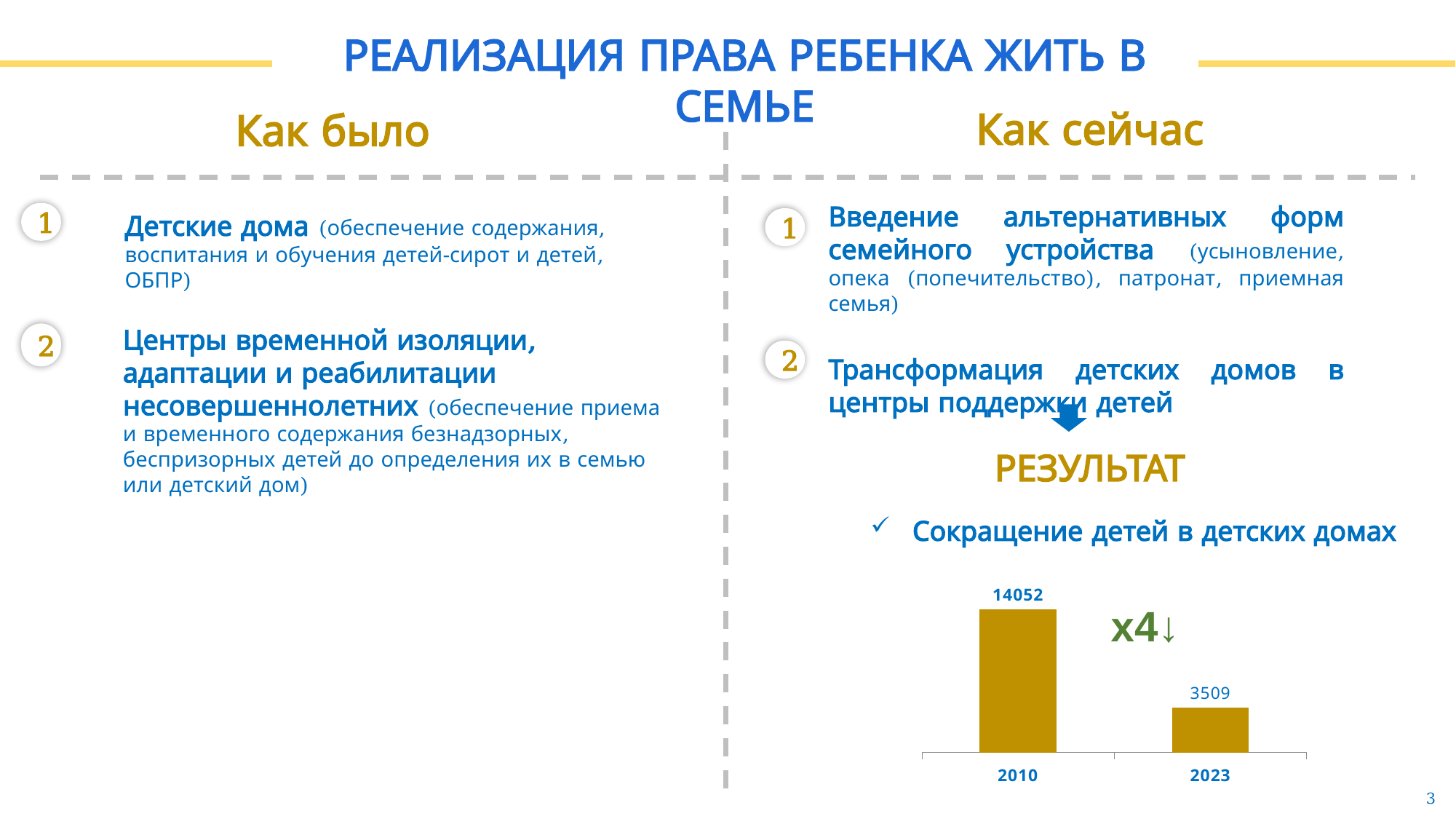
Do the values rise or fall from 2010 to 2023? fall What colour are the bars in the chart? gold What is the value shown for 2010 in the chart? 14052 What kind of chart is shown on the slide? bar chart Which year has the higher value in the chart? 2010 What is the value shown for 2023 in the chart? 3509 Is the value for 2023 larger or smaller than the value for 2010? smaller How many bars are plotted in the chart? 2 What reduction factor is annotated next to the chart? x4 What is the difference between the 2010 value and the 2023 value? 10543 Which year has the lower value in the chart? 2023